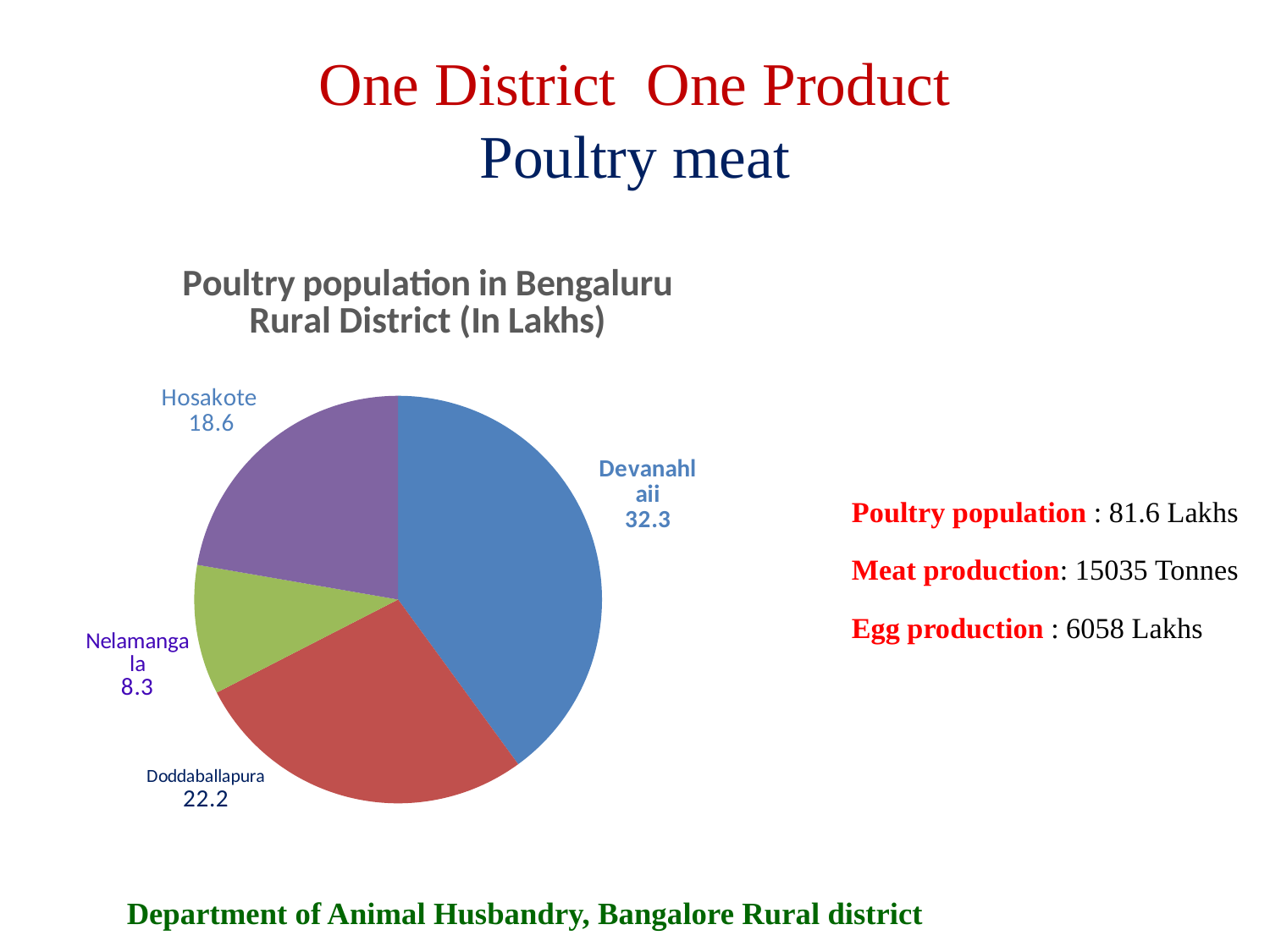
Which taluk has the largest poultry population in the pie chart? Devanahlaii What is the poultry population value shown for Hosakote? 18.6 What is the poultry population value shown for Nelamangala? 8.3 What is the poultry population value shown for Devanahlaii? 32.3 What type of chart is used to show the poultry population in Bengaluru Rural District? Pie chart What is the difference between the poultry population values for Hosakote and Nelamangala? 10.3 What is the title of the chart on the slide? Poultry population in Bengaluru Rural District (In Lakhs) What is the poultry population value shown for Doddaballapura? 22.2 What is the difference between the poultry population values for Devanahlaii and Doddaballapura? 10.1 Which taluk has the smallest poultry population in the pie chart? Nelamangala Which has a larger poultry population, Doddaballapura or Hosakote? Doddaballapura How many taluks are shown as slices in the pie chart? 4